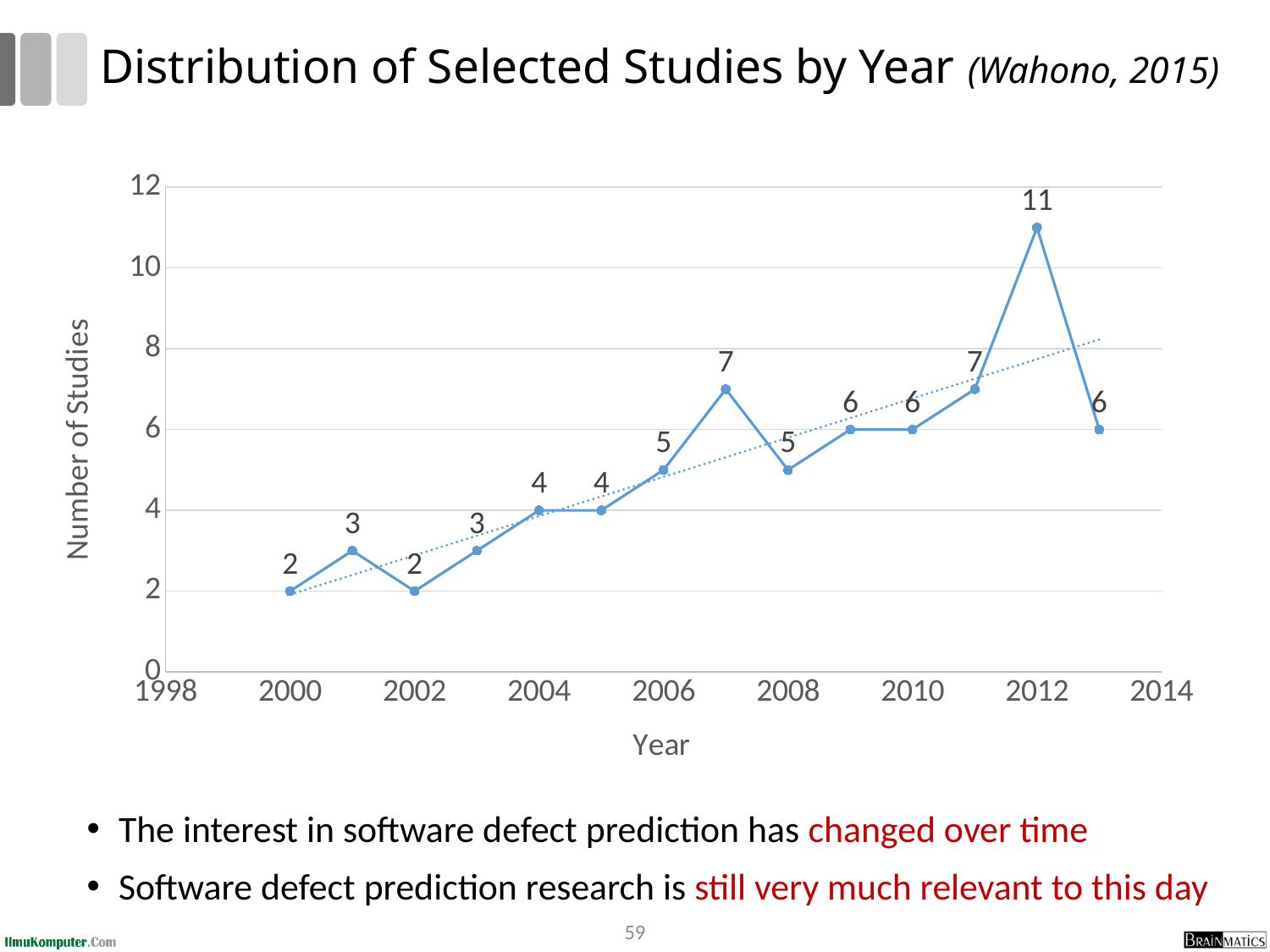
Which year has the highest number of studies? 2012 What is the number of studies for 2007? 7 What is the label of the x axis? Year How many data points are plotted on the line? 14 What is the number of studies for 2000? 2 How many studies were selected in 2012? 11 What is the label of the y axis? Number of Studies Overall, does the number of studies rise or fall from 2000 to 2013? rise What kind of chart is shown on the slide? line chart Which year has more studies, 2011 or 2009? 2011 What is the difference in the number of studies between 2007 and 2008? 2 What is the difference in the number of studies between 2012 and 2013? 5